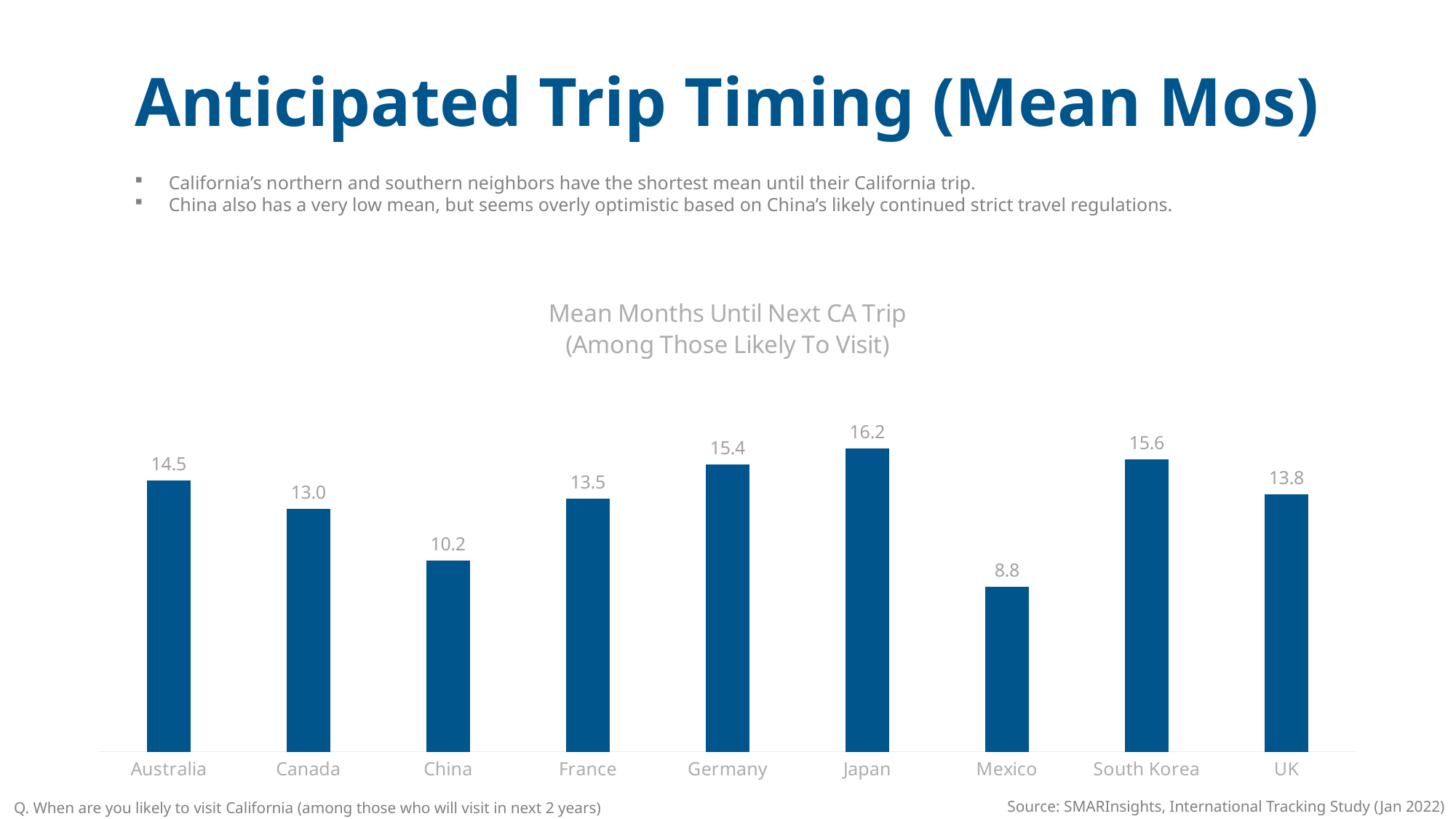
What is the title of the chart? Mean Months Until Next CA Trip (Among Those Likely To Visit) What is the difference between the mean months for Germany and Canada? 2.4 Which has a lower mean months until next CA trip, China or Canada? China What kind of chart is shown on the slide? Bar chart What is the mean months until next CA trip for Mexico? 8.8 Which country has the lowest mean months until next CA trip? Mexico What is the mean months until next CA trip for Australia? 14.5 What is the mean months until next CA trip for South Korea? 15.6 What is the difference between the mean months for Japan and Mexico? 7.4 Which has a higher mean months until next CA trip, France or the UK? UK Which country has the highest mean months until next CA trip? Japan How many countries are shown in the chart? 9